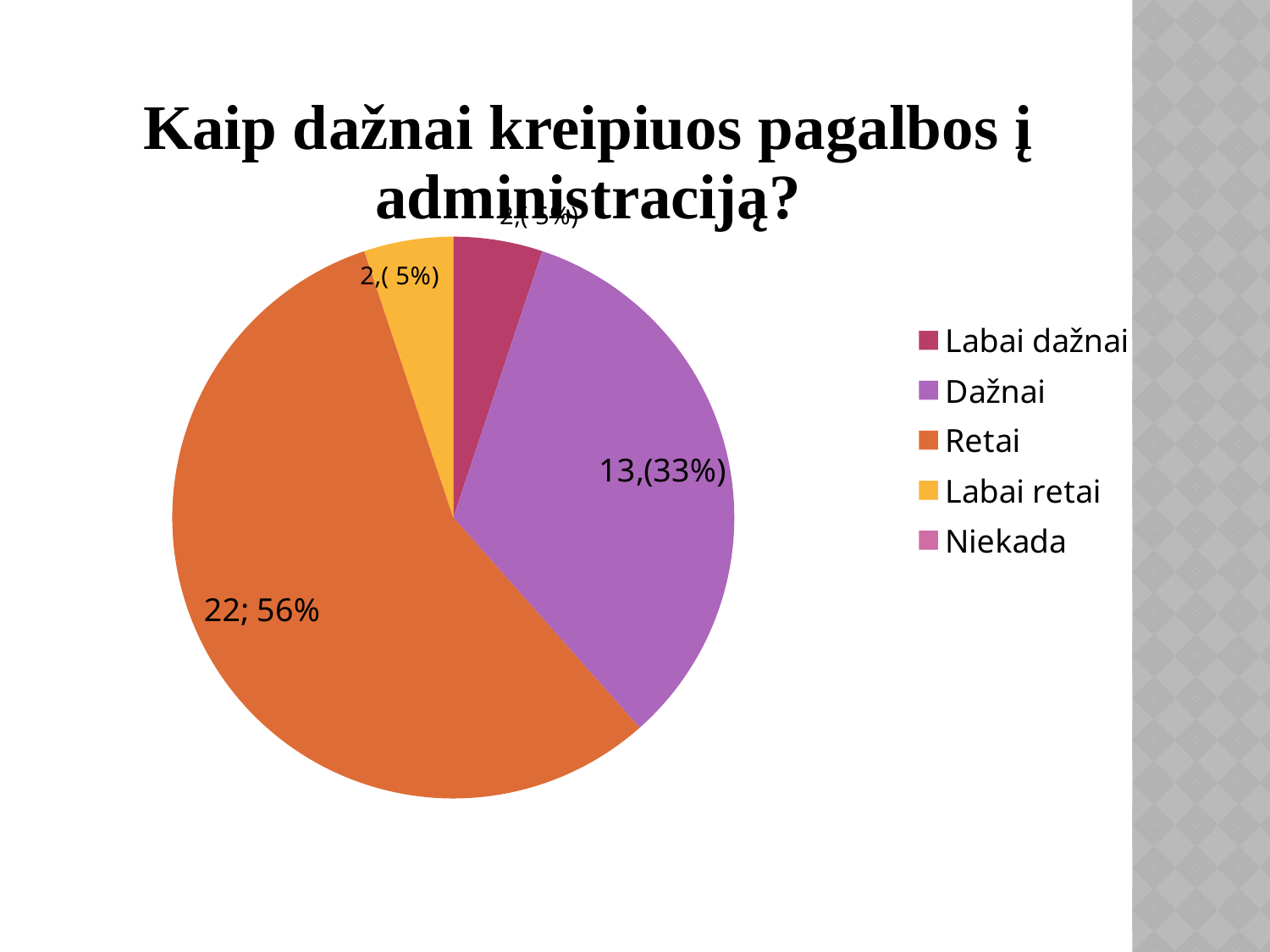
What is the data label shown for the Labai retai slice? 2,( 5%) What kind of chart is shown on the slide? pie chart Which is larger, the Dažnai slice or the Labai retai slice? Dažnai What share of the pie does the Dažnai slice represent? 33% Which category has the largest slice of the pie? Retai What is the title of the chart? Kaip dažnai kreipiuos pagalbos į administraciją? What is the difference in count between the Retai slice (22) and the Dažnai slice (13)? 9 How many entries does the legend list? 5 Which colour is used for the Retai slice? orange What share of the pie does the Retai slice represent? 56% What is the data label shown for the Dažnai slice? 13,(33%) What is the data label shown for the Retai slice? 22; 56%